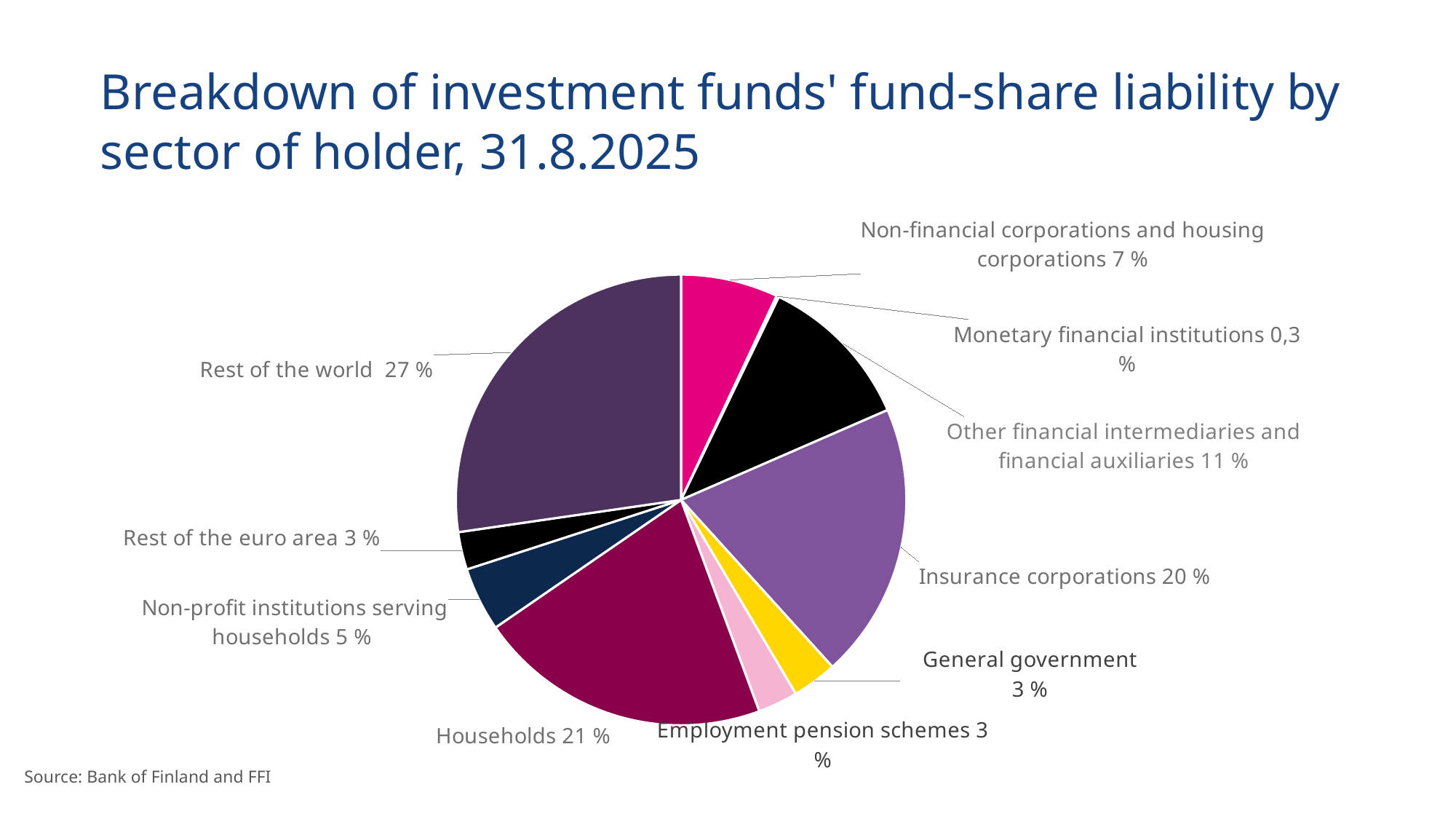
Which sector holds the largest share of the pie? Rest of the world What share of the pie does Rest of the world hold? 27 % What is the value shown for Non-profit institutions serving households? 5 % What is the value shown for Insurance corporations? 20 % What is the value shown for Monetary financial institutions? 0,3 % What is the difference in percentage points between Insurance corporations and Other financial intermediaries and financial auxiliaries? 9 Which sector holds the smallest share of the pie? Monetary financial institutions What is the value shown for Households? 21 % Which is larger, the share for Households or the share for Insurance corporations? Households What is the difference in percentage points between Rest of the world and Households? 6 What kind of chart is shown on the slide? Pie chart How many sectors are shown in the pie chart? 10